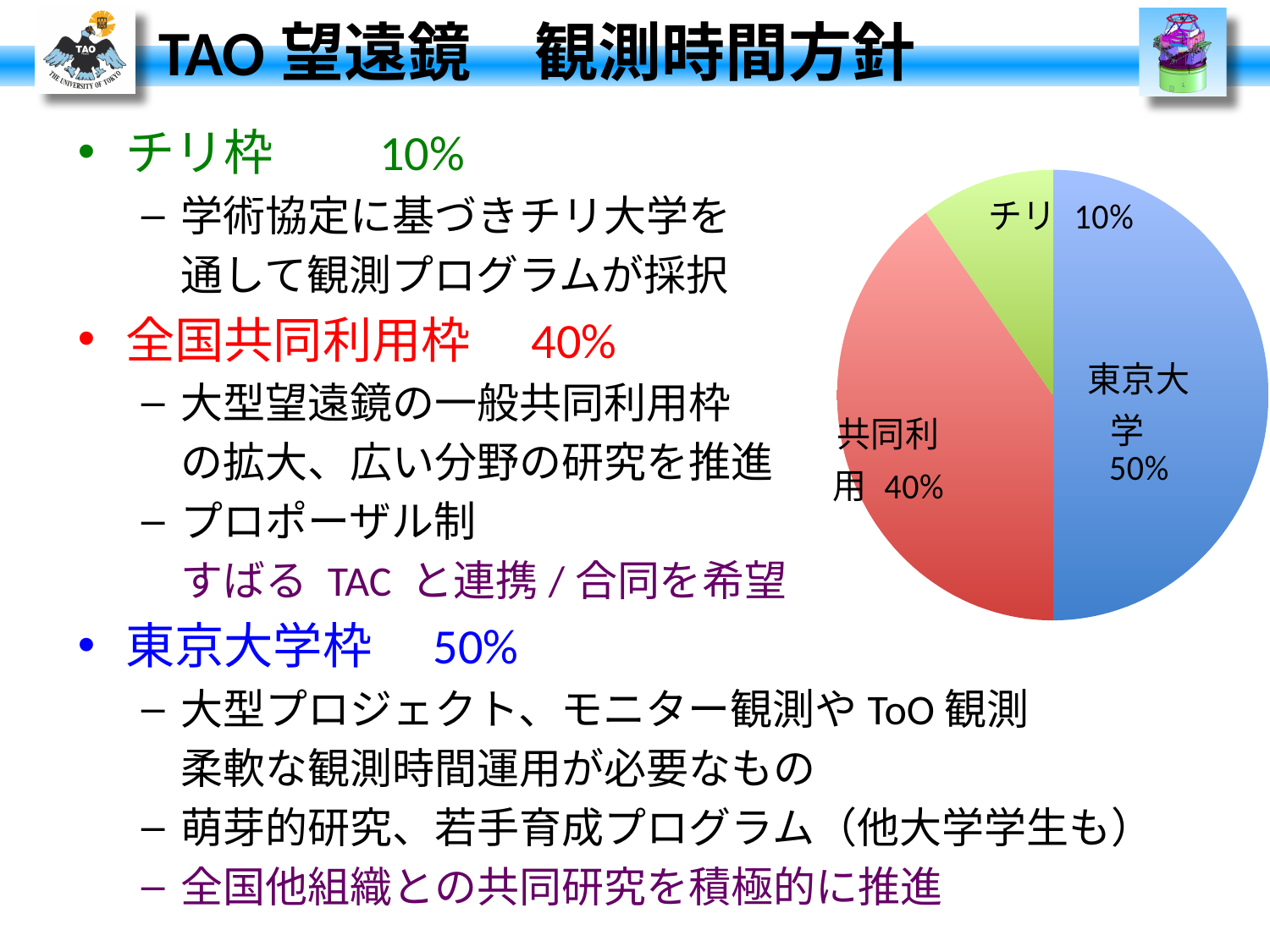
Which is larger, the 共同利用 slice or the チリ slice? 共同利用 What share of the pie does 東京大学 have? 50% What kind of chart is shown on the slide? pie chart What is the difference in percentage points between the 東京大学 slice and the 共同利用 slice? 10 What share of the pie does 共同利用 have? 40% Which slice of the pie chart is the smallest? チリ What colour is the 東京大学 slice in the pie chart? blue How many slices does the pie chart have? 3 What share of the pie does チリ have? 10% Which slice of the pie chart is the largest? 東京大学 What colour is the チリ slice in the pie chart? green What is the difference in percentage points between the 共同利用 slice and the チリ slice? 30